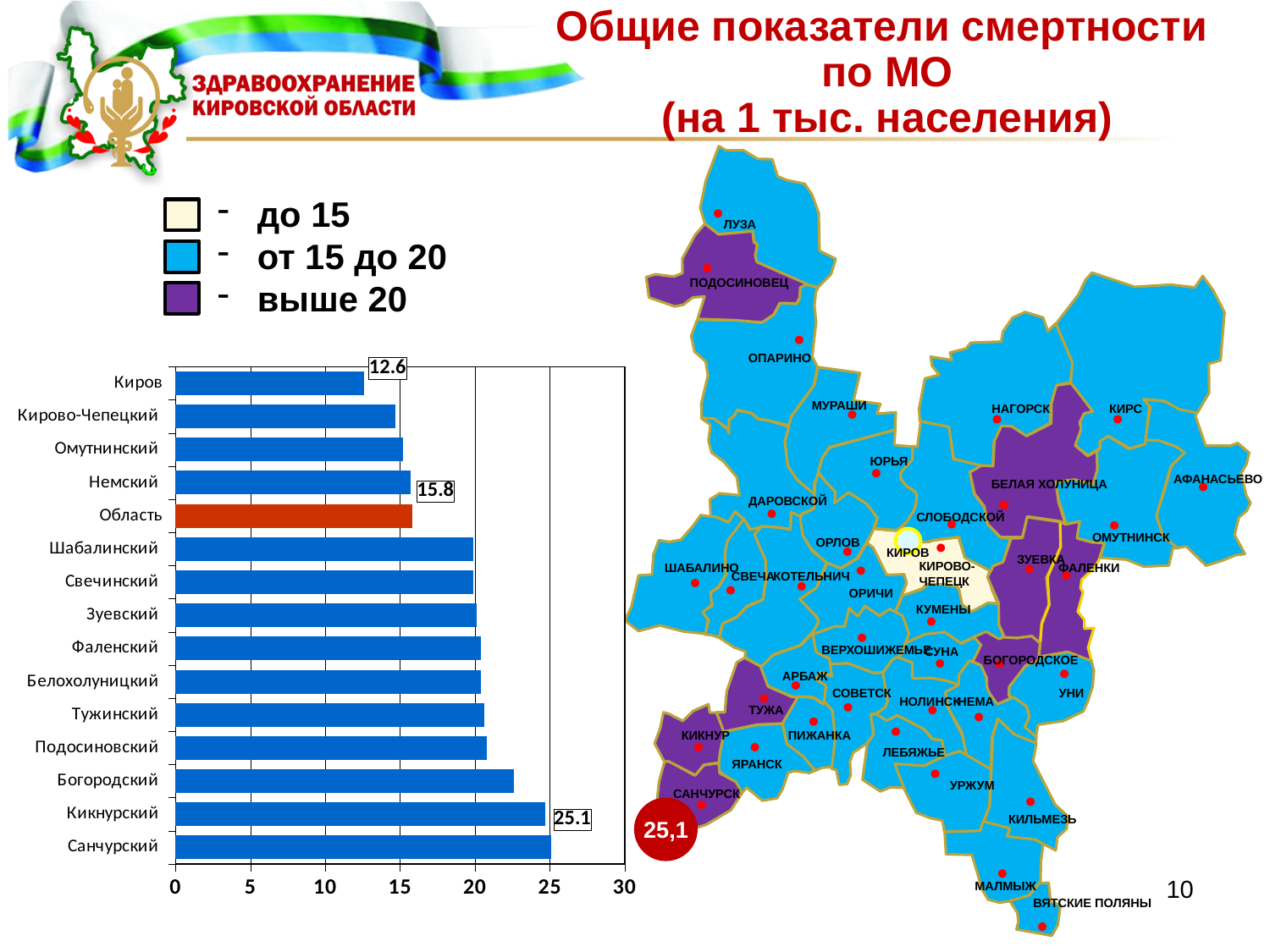
What kind of chart is shown on the slide? bar chart Which is larger, the value for Кикнурский or the value for Немский? Кикнурский What is the value for Киров in the bar chart? 12.6 Which category has the highest value in the bar chart? Санчурский What is the value for Область in the bar chart? 15.8 How many categories are shown in the bar chart? 15 What is the value for Санчурский in the bar chart? 25.1 What is the difference between the values for Область and Киров? 3.2 Which category has the lowest value in the bar chart? Киров What is the difference between the values for Санчурский and Киров? 12.5 Is the value for Богородский greater or less than 20? greater